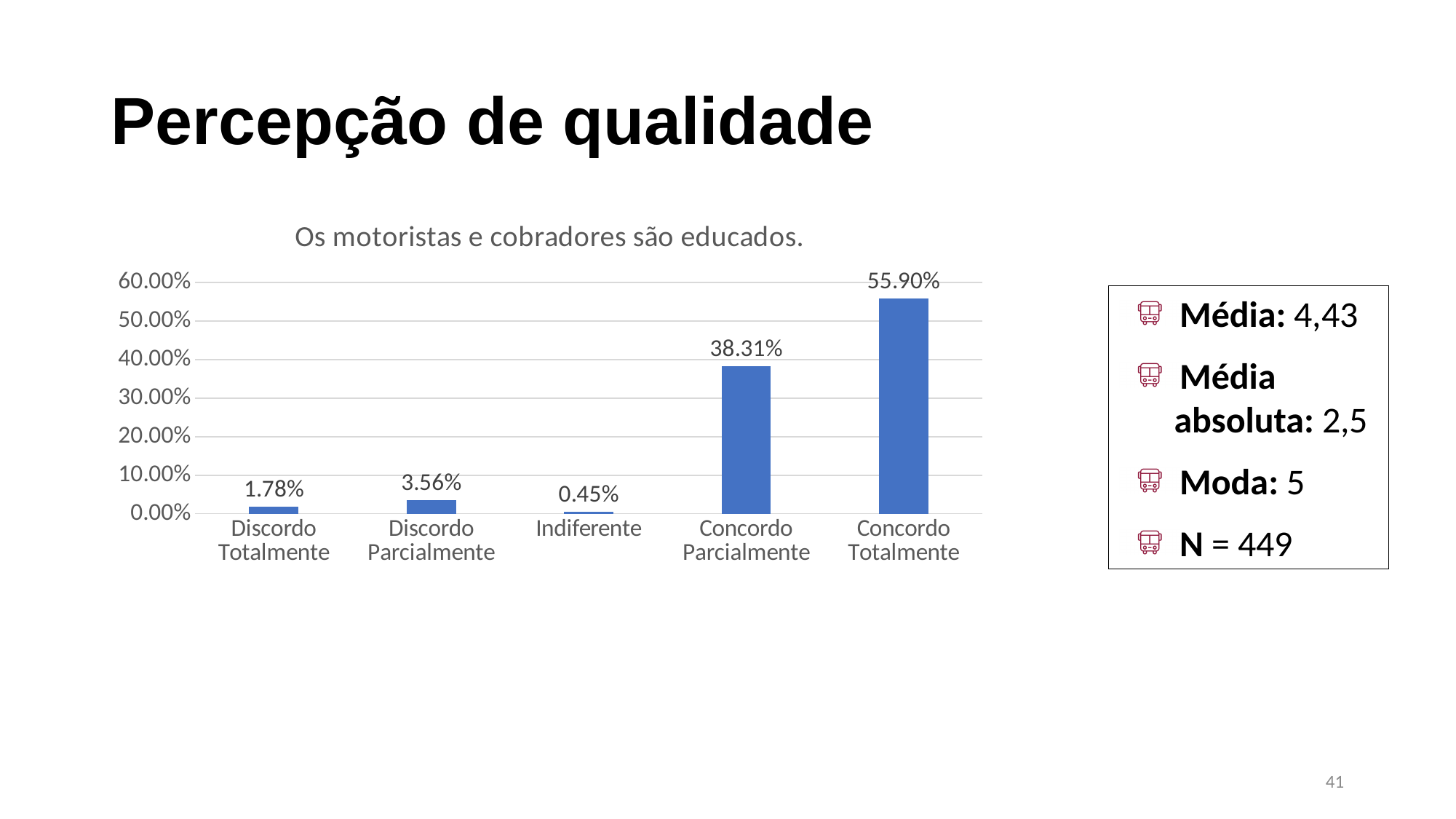
What is the title of the chart? Os motoristas e cobradores são educados. What is the difference between Discordo Parcialmente and Discordo Totalmente? 1.78% Which category has the highest value? Concordo Totalmente What is the value for Indiferente? 0.45% What is the value for Discordo Parcialmente? 3.56% What is the value for Concordo Totalmente? 55.90% What kind of chart is shown on the slide? bar chart How many categories are shown on the x axis? 5 Which category has the lowest value? Indiferente Which is larger, Discordo Totalmente or Discordo Parcialmente? Discordo Parcialmente What is the difference between Concordo Totalmente and Concordo Parcialmente? 17.59% Is the value for Concordo Parcialmente greater or less than 30.00%? greater